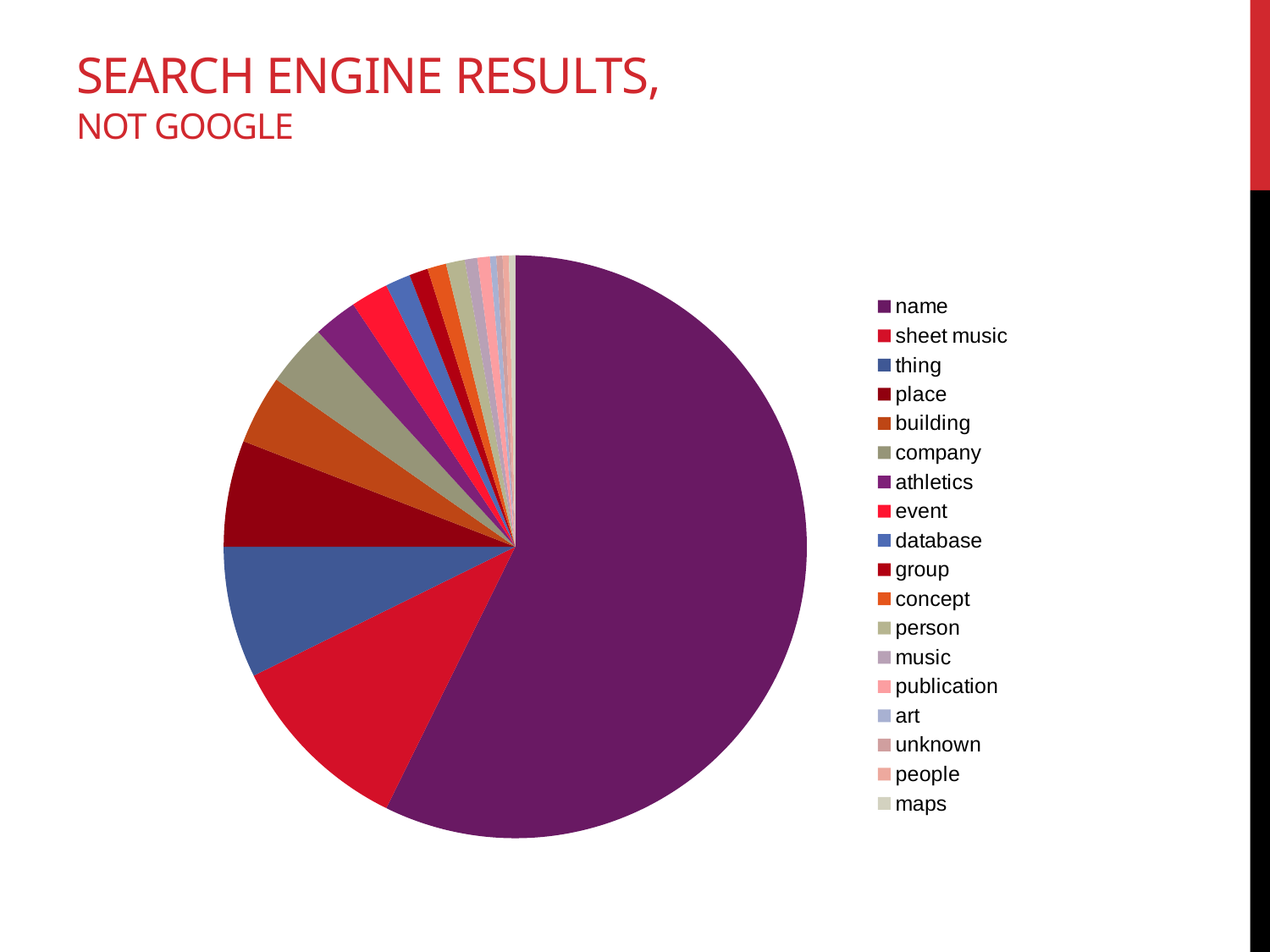
Which category is listed first in the pie chart's legend? name What is the title of the slide containing the pie chart? SEARCH ENGINE RESULTS, NOT GOOGLE Which slice is larger, event or database? event Which slice is larger, company or athletics? company What kind of chart is shown on the slide? pie chart Which slice is larger, thing or place? thing How many categories does the pie chart's legend list? 18 Which category has the largest slice of the pie? name